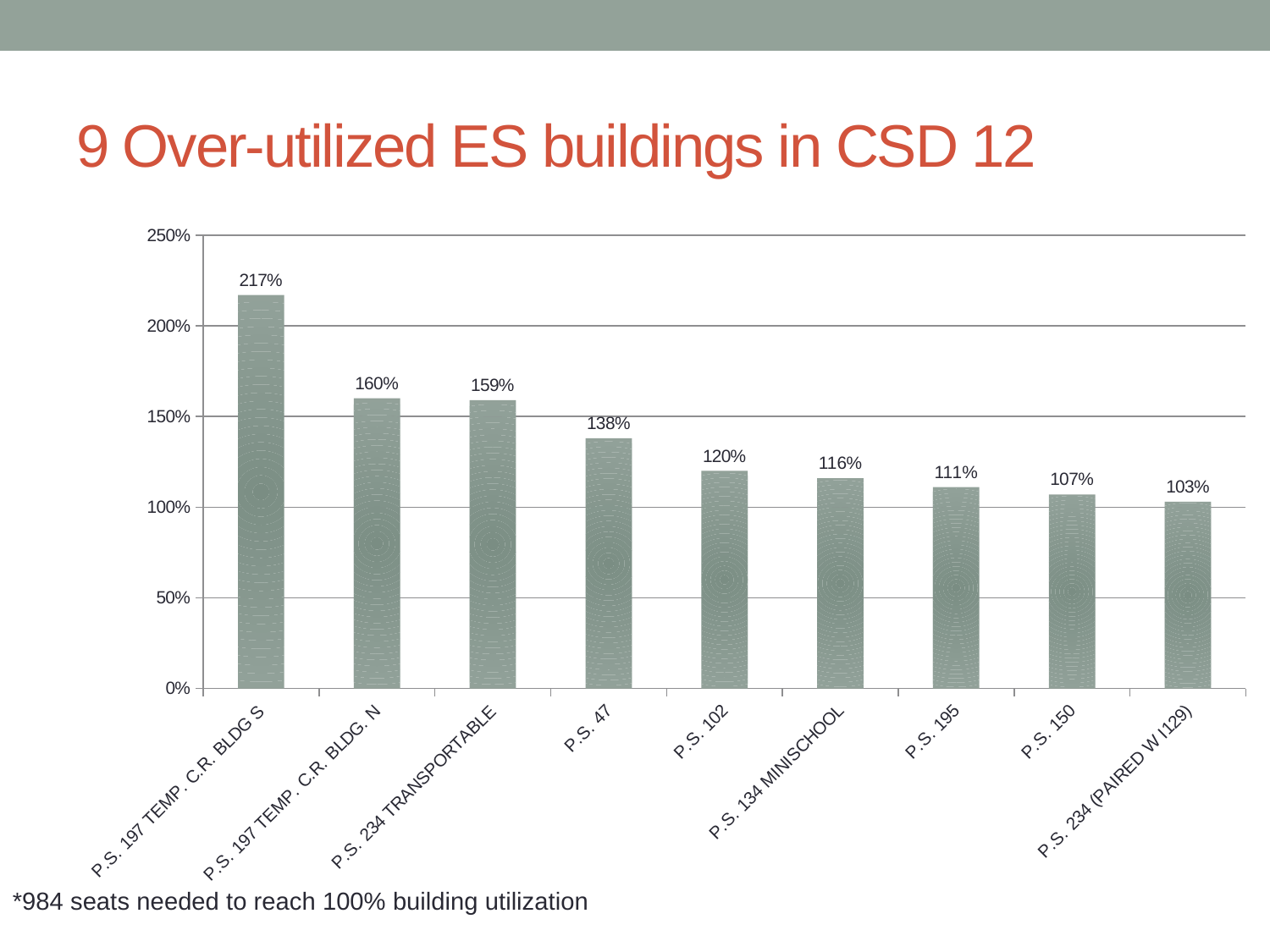
Which building has the lowest utilization? P.S. 234 (PAIRED W I129) What is the difference between the utilization of P.S. 102 and P.S. 150? 13% What is the difference between the utilization of P.S. 197 TEMP. C.R. BLDG S and P.S. 197 TEMP. C.R. BLDG N? 57% What is the utilization value for P.S. 47? 138% Which building has the highest utilization? P.S. 197 TEMP. C.R. BLDG S How many buildings are shown in the chart? 9 What is the utilization value for P.S. 234 TRANSPORTABLE? 159% Which has a higher utilization, P.S. 195 or P.S. 102? P.S. 102 What kind of chart is shown on the slide? bar chart Do the values rise or fall from left to right along the x axis? fall Is the value for P.S. 47 greater or less than 150%? less What is the utilization value for P.S. 134 MINISCHOOL? 116%